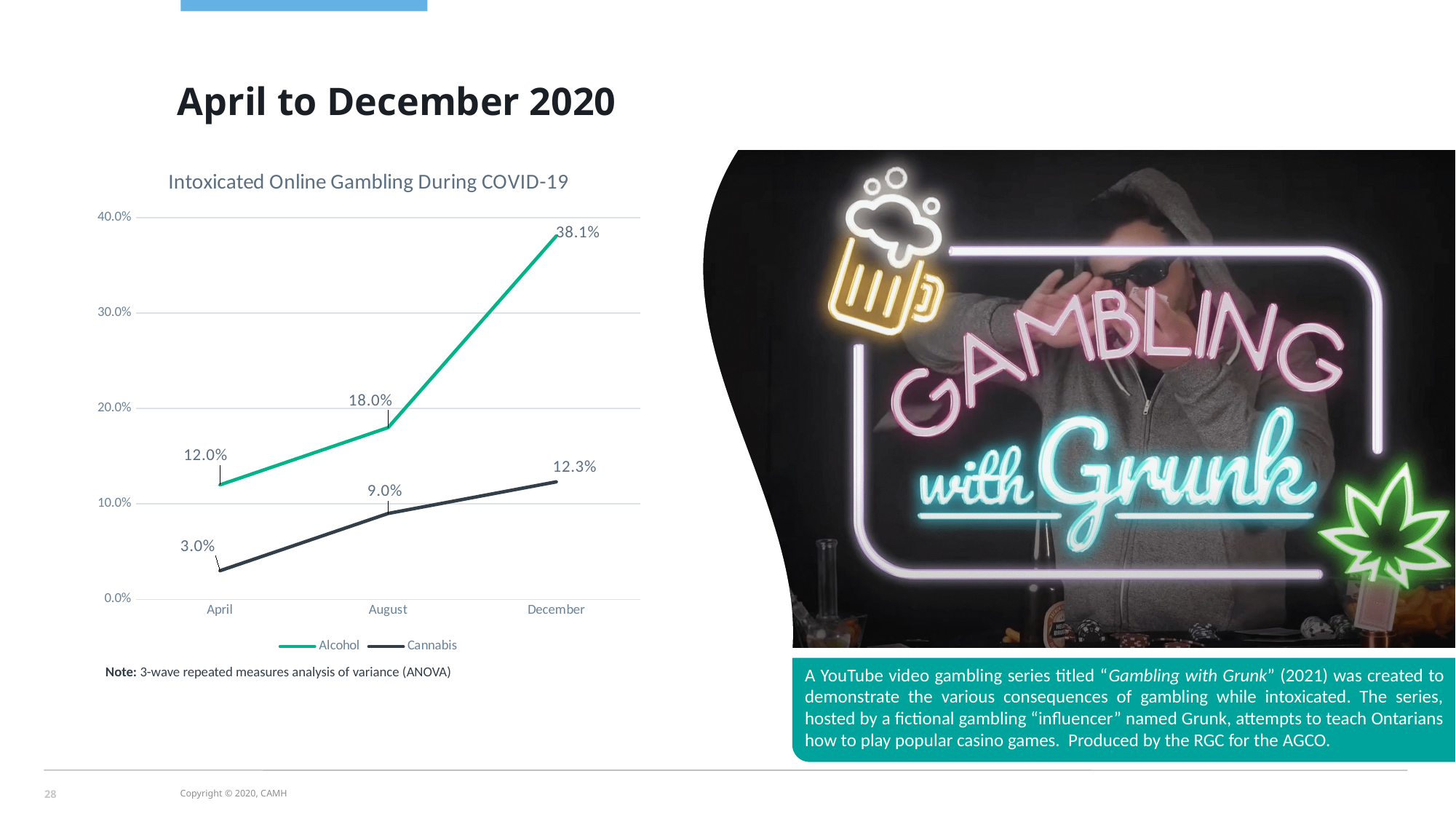
What is the value for Cannabis in April? 3.0% In which month is the Alcohol value highest? December What is the value for Alcohol in August? 18.0% What kind of chart is shown? Line chart What is the difference between the Alcohol and Cannabis values in December? 25.8% What is the value for Cannabis in December? 12.3% Do the Alcohol values rise or fall from April to December? Rise How many months are shown on the x axis? 3 What is the value for Alcohol in December? 38.1% Which is larger in August, the Alcohol value or the Cannabis value? Alcohol How many series does the legend list? 2 In which month is the Cannabis value lowest? April